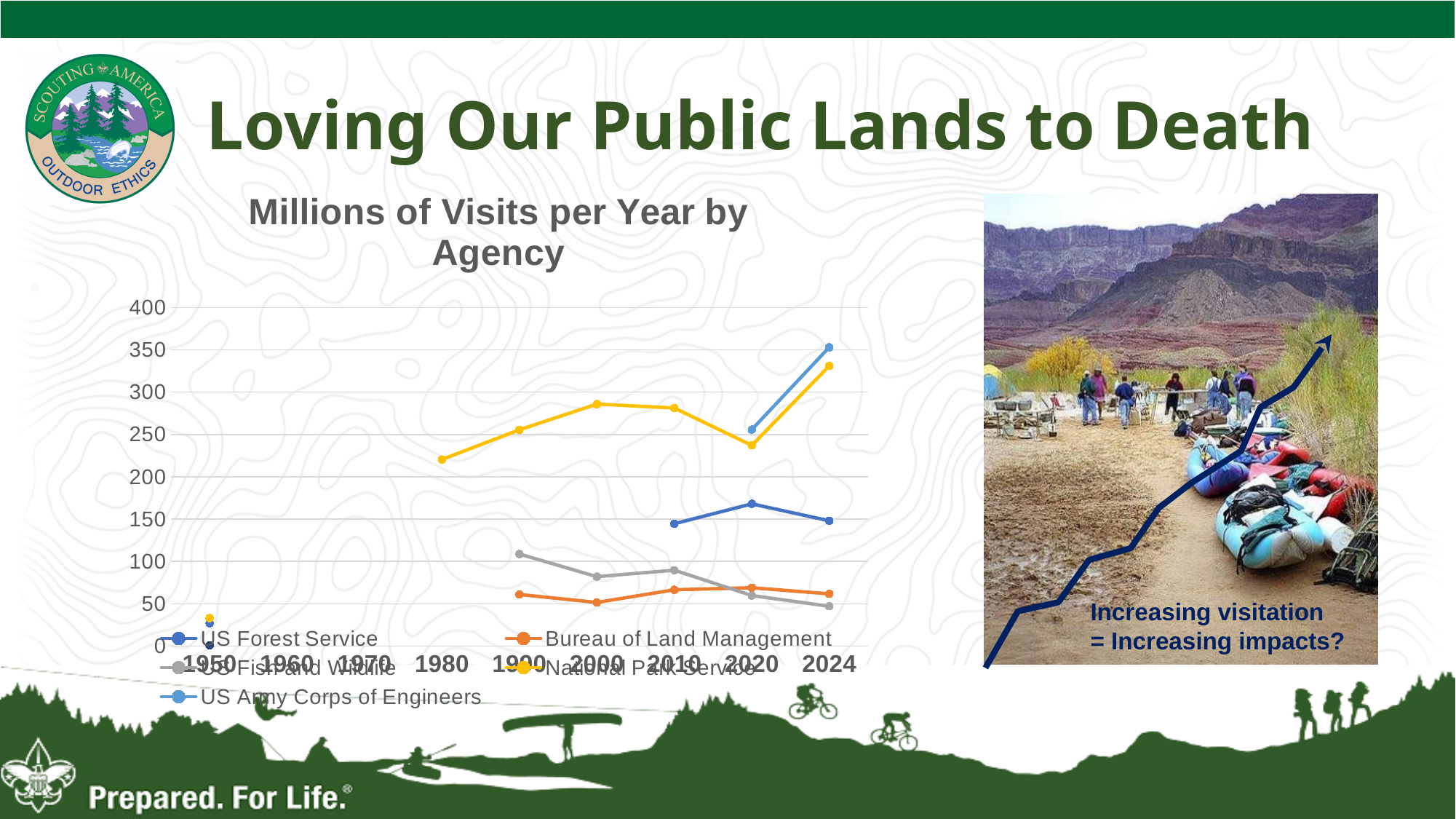
Is the value for National Park Service in 1980 greater or less than 250? less Is the value for Bureau of Land Management in 2000 greater or less than 100? less What kind of chart is shown on the slide? line chart Which agency has the highest value in 2024? US Army Corps of Engineers How many year labels are shown on the x axis? 9 Which agency has the lowest value in 2024? US Fish and Wildlife Is the value for US Army Corps of Engineers in 2024 greater or less than 300? greater Does the National Park Service line rise or fall from 2020 to 2024? rise What is the title of the chart? Millions of Visits per Year by Agency Which is larger for National Park Service: the value in 2000 or the value in 2020? 2000 How many series does the chart legend list? 5